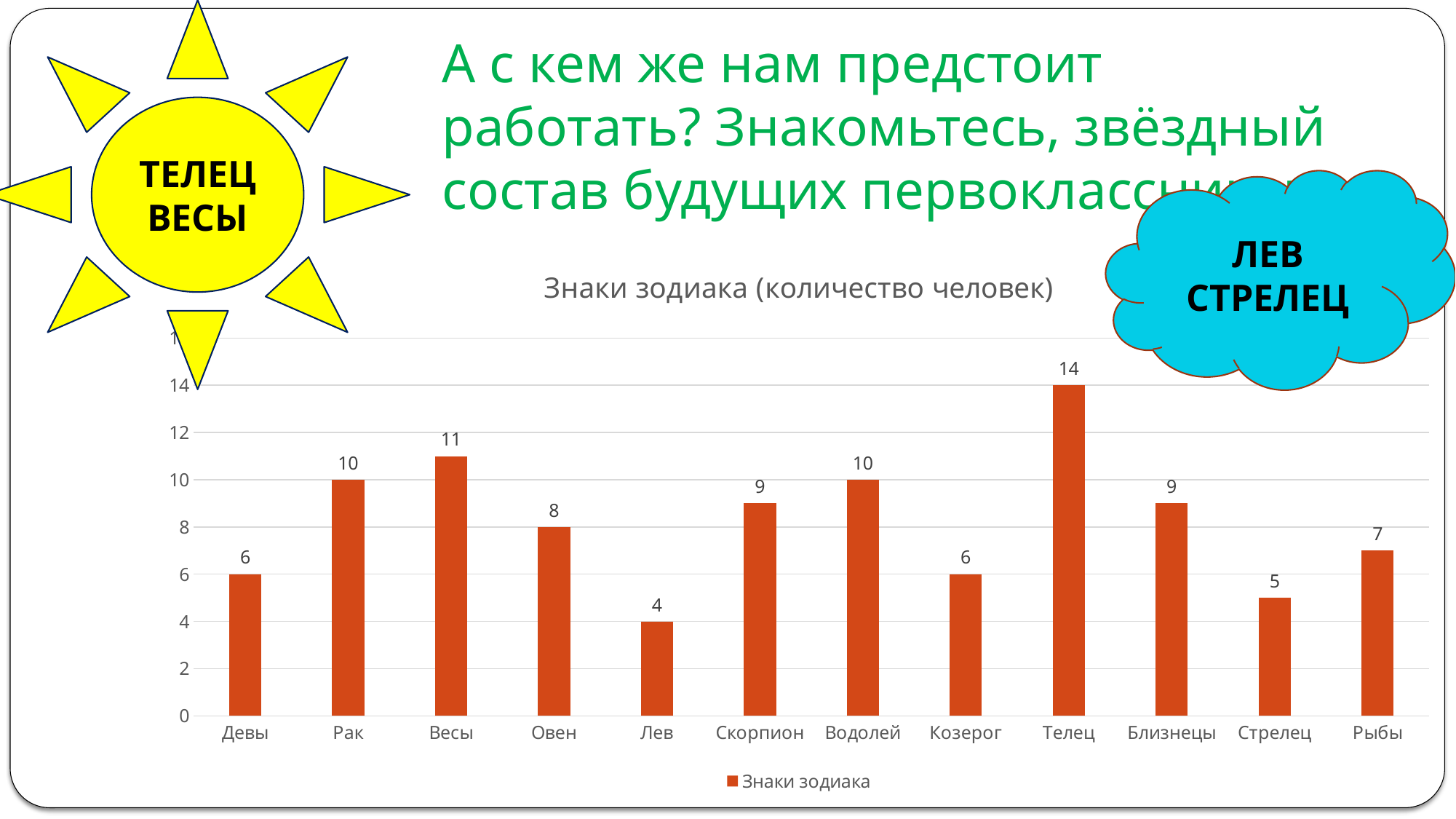
How many categories are shown on the x axis? 12 What is the difference between the values for Телец and Стрелец? 9 What is the title of the chart? Знаки зодиака (количество человек) What is the value for Рыбы? 7 What is the value for Лев? 4 Which category has the highest value? Телец Is the value for Близнецы greater or less than 8? greater What is the value for Телец? 14 How many series does the legend list? 1 Which category has the lowest value? Лев Which is larger, the value for Весы or the value for Овен? Весы What kind of chart is shown? bar chart